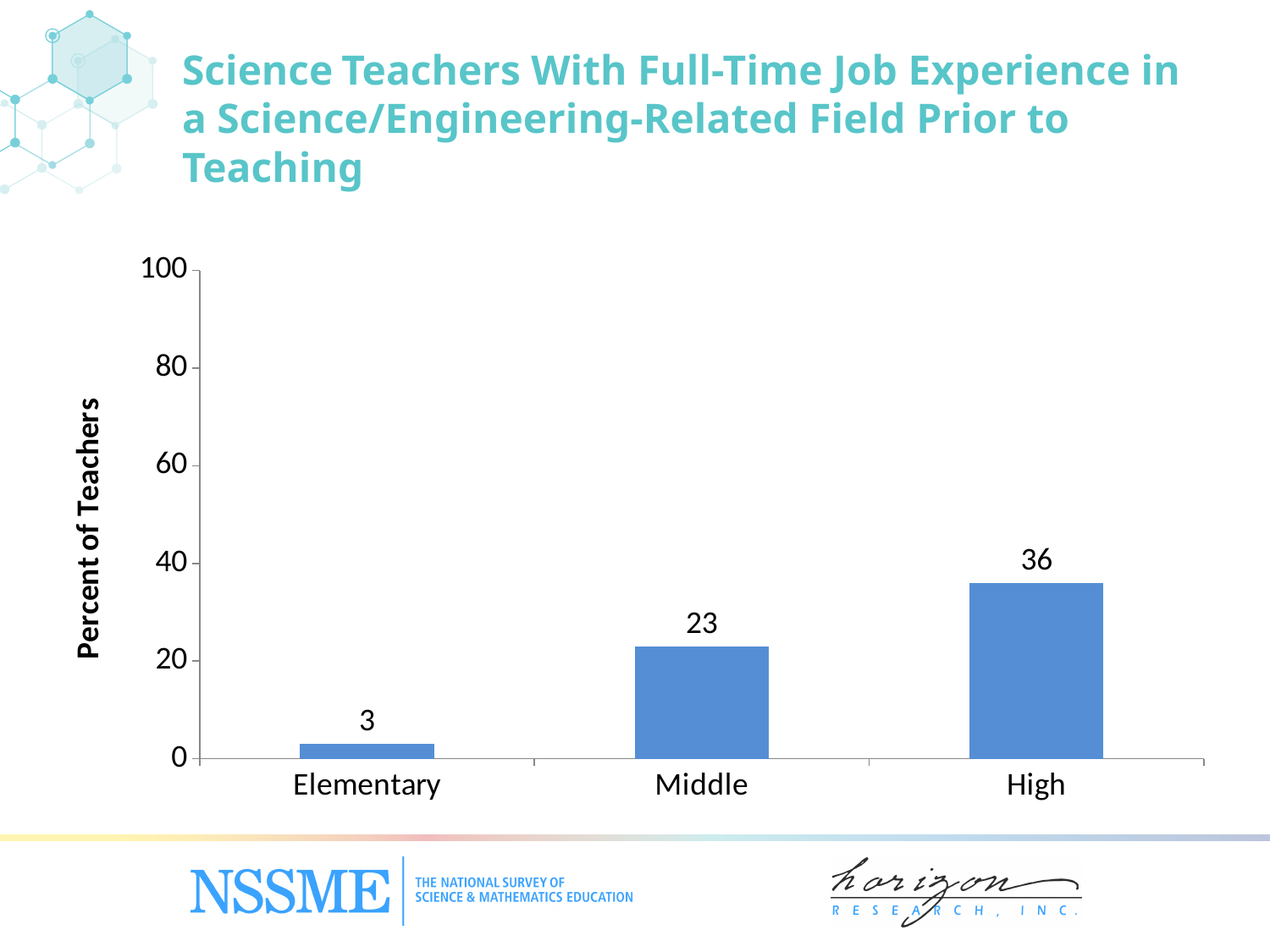
What is the value for Elementary? 3 What is the difference between the values for Middle and Elementary? 20 What is the value for High? 36 What is the value for Middle? 23 What is the label of the y axis? Percent of Teachers Which category has the lowest value? Elementary What is the difference between the values for High and Middle? 13 Is the value for High greater or less than 40? less Which category has the highest value? High Which is larger, the value for Middle or the value for High? High What kind of chart is shown on the slide? bar chart How many categories are shown on the x axis? 3